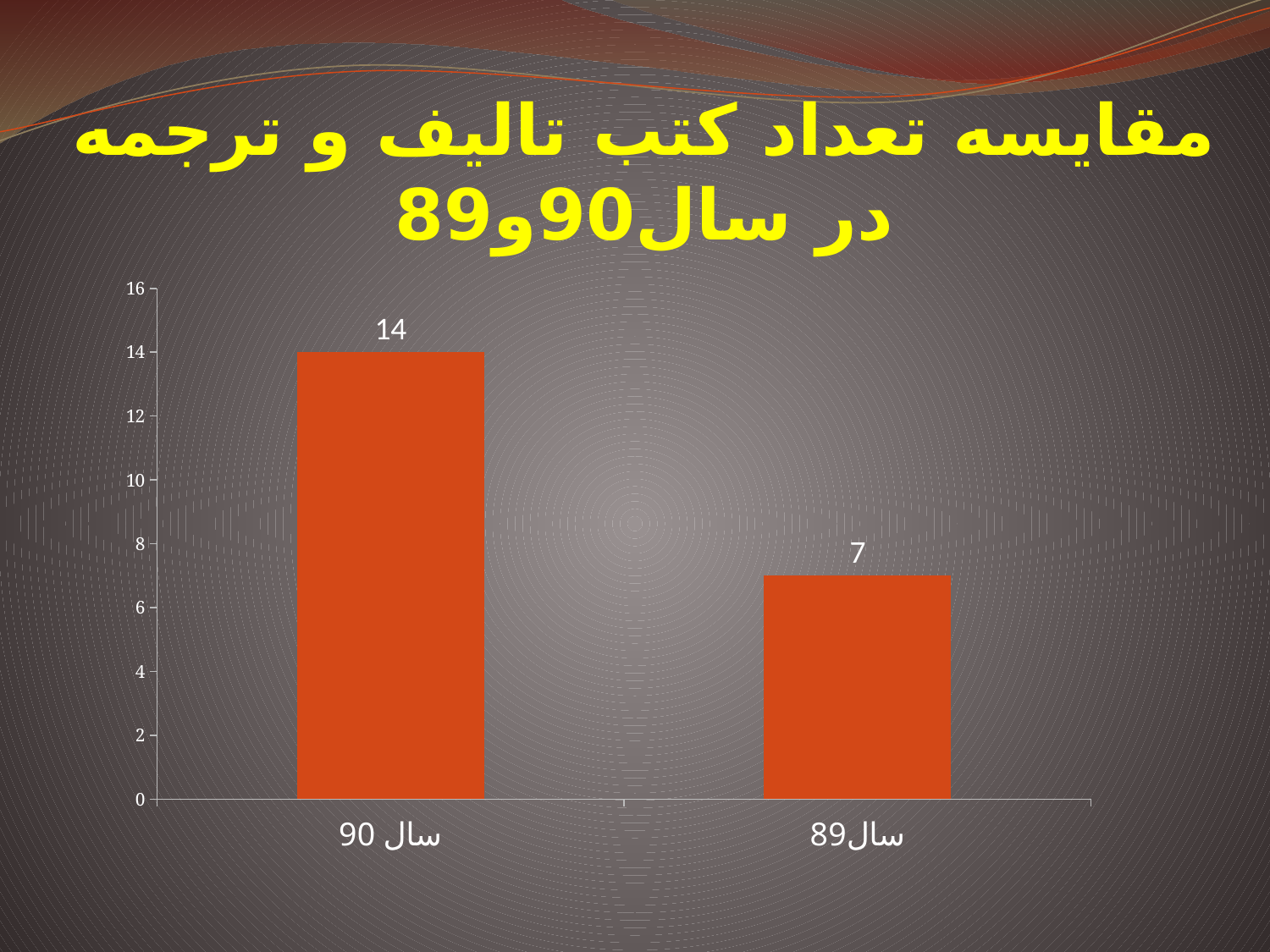
How many categories are shown on the x axis? 2 What is the value for سال89? 7 What is the difference between the values for سال 90 and سال89? 7 What colour are the bars in the chart? orange-red Which is larger, the value for سال 90 or the value for سال89? سال 90 Is the value for سال89 greater or less than 8? less What is the value for سال 90? 14 Which category has the lowest value? سال89 Is the value for سال 90 greater or less than 10? greater What is the maximum value shown on the vertical axis? 16 What kind of chart is shown on the slide? bar chart Which category has the highest value? سال 90